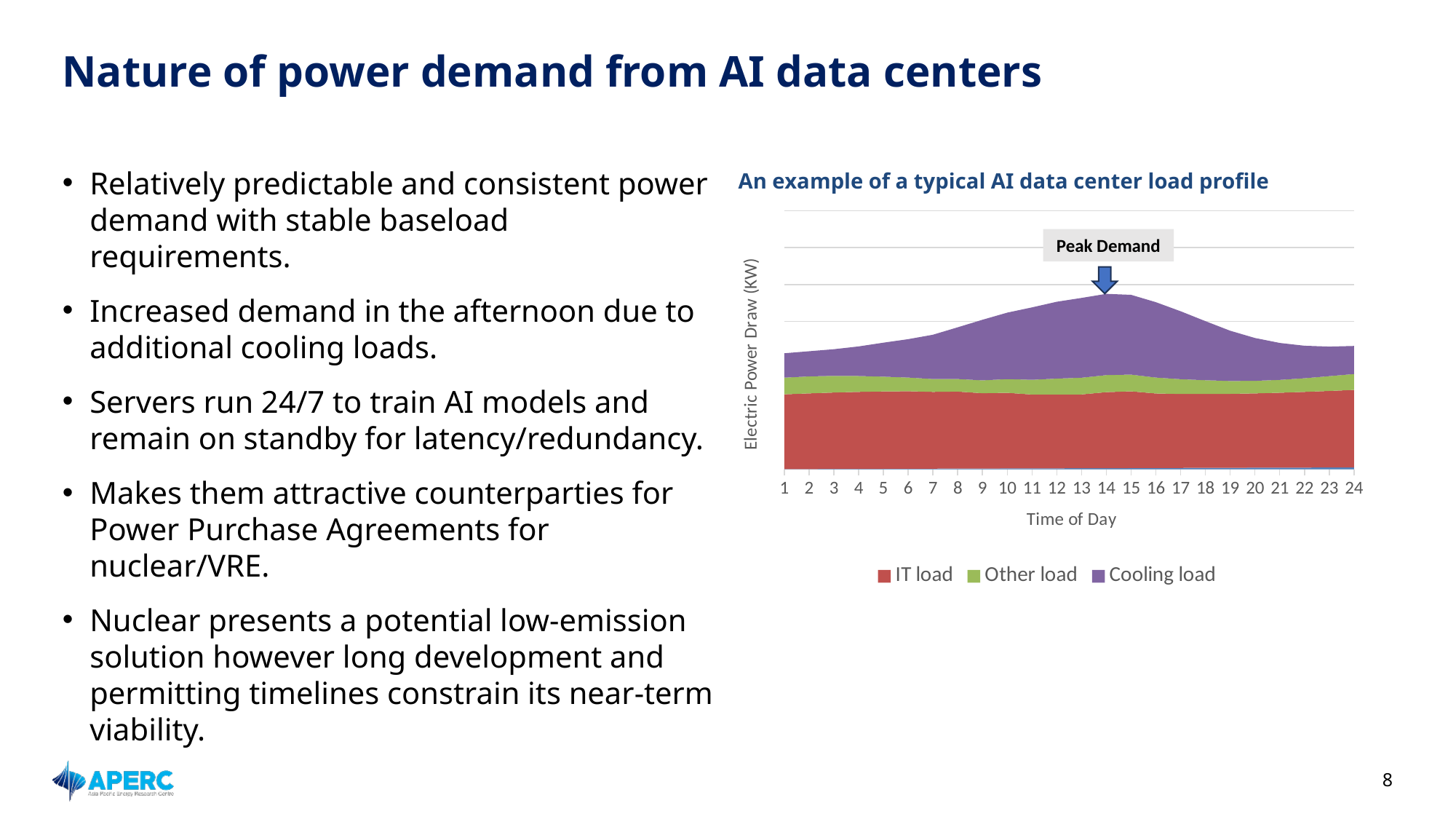
Does the total power draw in the chart rise or fall from hour 15 to hour 24? Fall At hour 14, which is larger in the chart: Cooling load or Other load? Cooling load Which hour on the x axis does the 'Peak Demand' arrow point to? 14 Which series in the chart accounts for the smallest share of the load throughout the day? Other load What kind of chart is shown on the slide? Stacked area chart Does the total power draw in the chart rise or fall from hour 1 to hour 14? Rise Which series in the chart grows the most during the afternoon hours? Cooling load How many time-of-day points are shown on the x axis of the chart? 24 How many series does the chart's legend list? 3 Which series in the chart accounts for the largest share of the load throughout the day? IT load What is the title of the chart? An example of a typical AI data center load profile What is the label of the y axis of the chart? Electric Power Draw (KW)